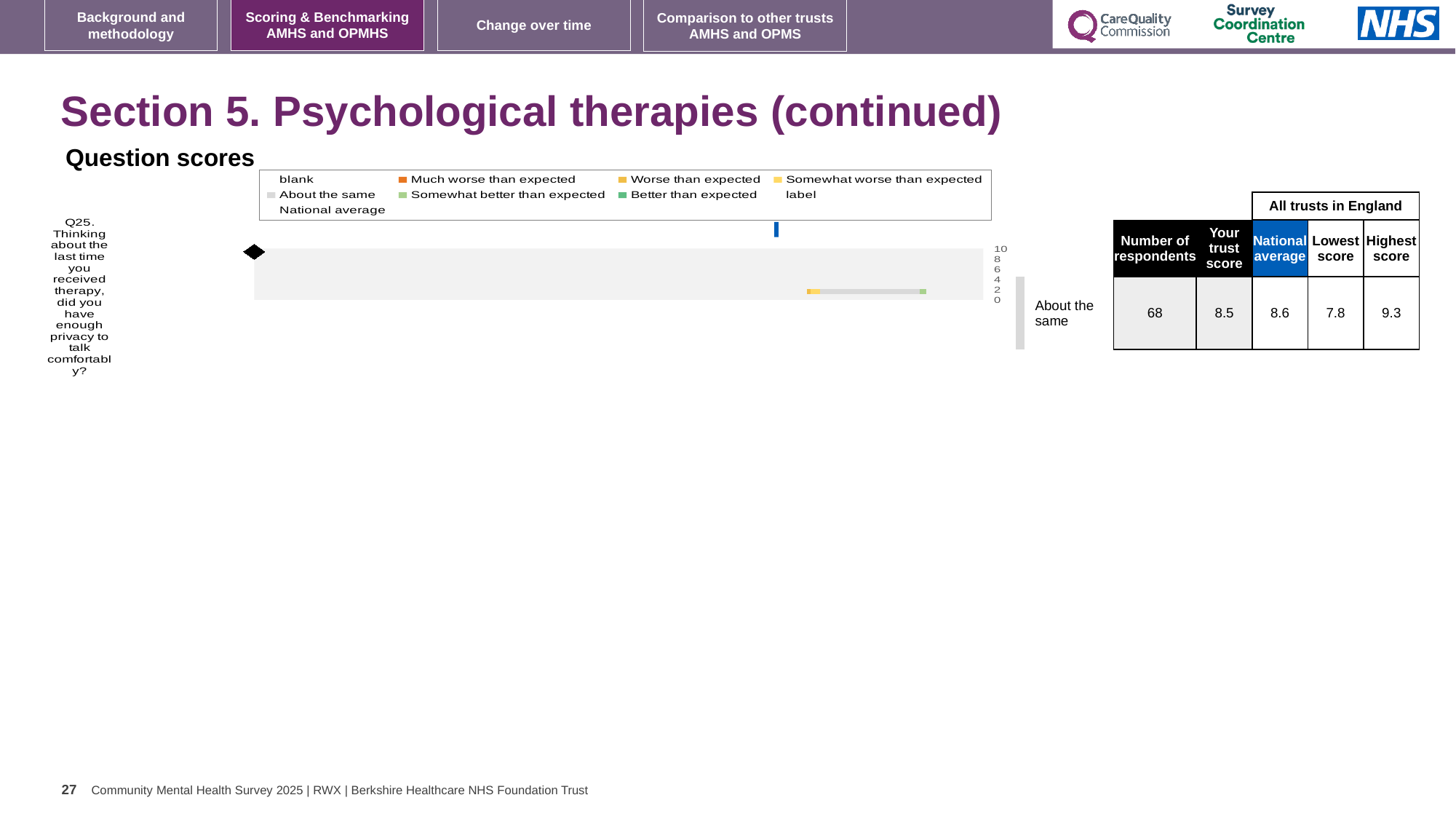
What is the national average score for Q25? 8.6 What is the difference between the national average and the trust's score for Q25? 0.1 How many respondents answered Q25? 68 What is the highest score among all trusts in England for Q25? 9.3 Which is larger for Q25: the trust's score or the national average? national average What kind of chart is used to show the Q25 question score? bar chart What is the lowest score among all trusts in England for Q25? 7.8 What is the trust's score for Q25 about having enough privacy to talk comfortably during therapy? 8.5 What is the highest value shown on the chart's score axis? 10 What benchmark category is the trust's Q25 score placed in? About the same What is the difference between the highest and lowest trust scores for Q25? 1.5 How many survey questions are plotted on the chart? 1